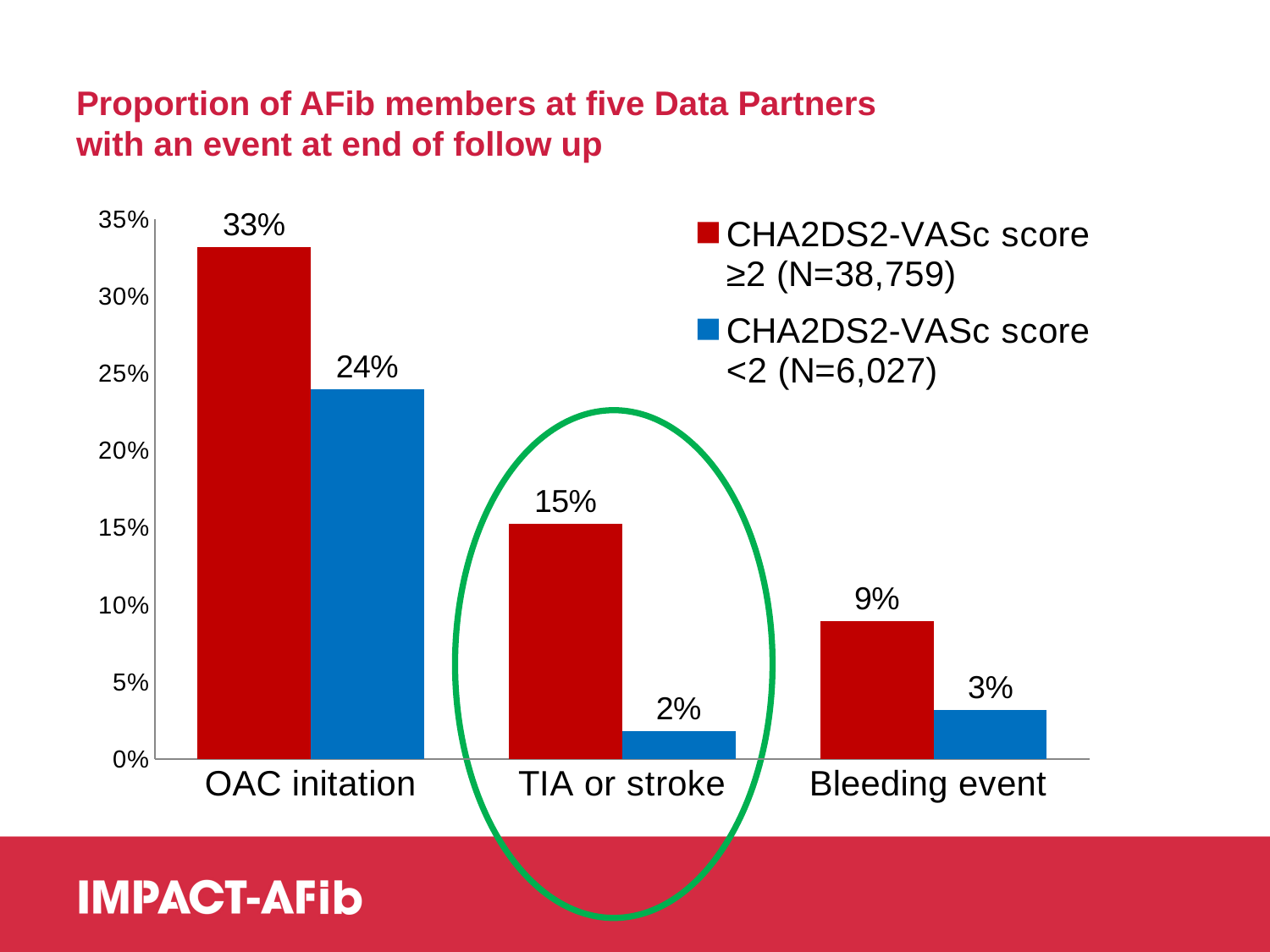
What is the value for OAC initation in the CHA2DS2-VASc score ≥2 (N=38,759) series? 33% What is the value for Bleeding event in the CHA2DS2-VASc score ≥2 (N=38,759) series? 9% What is the difference between the two series for OAC initation? 9% Which category has the lowest value in the CHA2DS2-VASc score ≥2 (N=38,759) series? Bleeding event What kind of chart is shown on the slide? Bar chart What is the difference between the two series for TIA or stroke? 13% Which category on the chart is circled in green? TIA or stroke Which is larger for Bleeding event: the CHA2DS2-VASc score ≥2 value or the CHA2DS2-VASc score <2 value? CHA2DS2-VASc score ≥2 (N=38,759) Which category has the highest value in the CHA2DS2-VASc score <2 (N=6,027) series? OAC initation What is the value for TIA or stroke in the CHA2DS2-VASc score <2 (N=6,027) series? 2% How many categories are shown on the x axis? 3 How many series does the legend list? 2